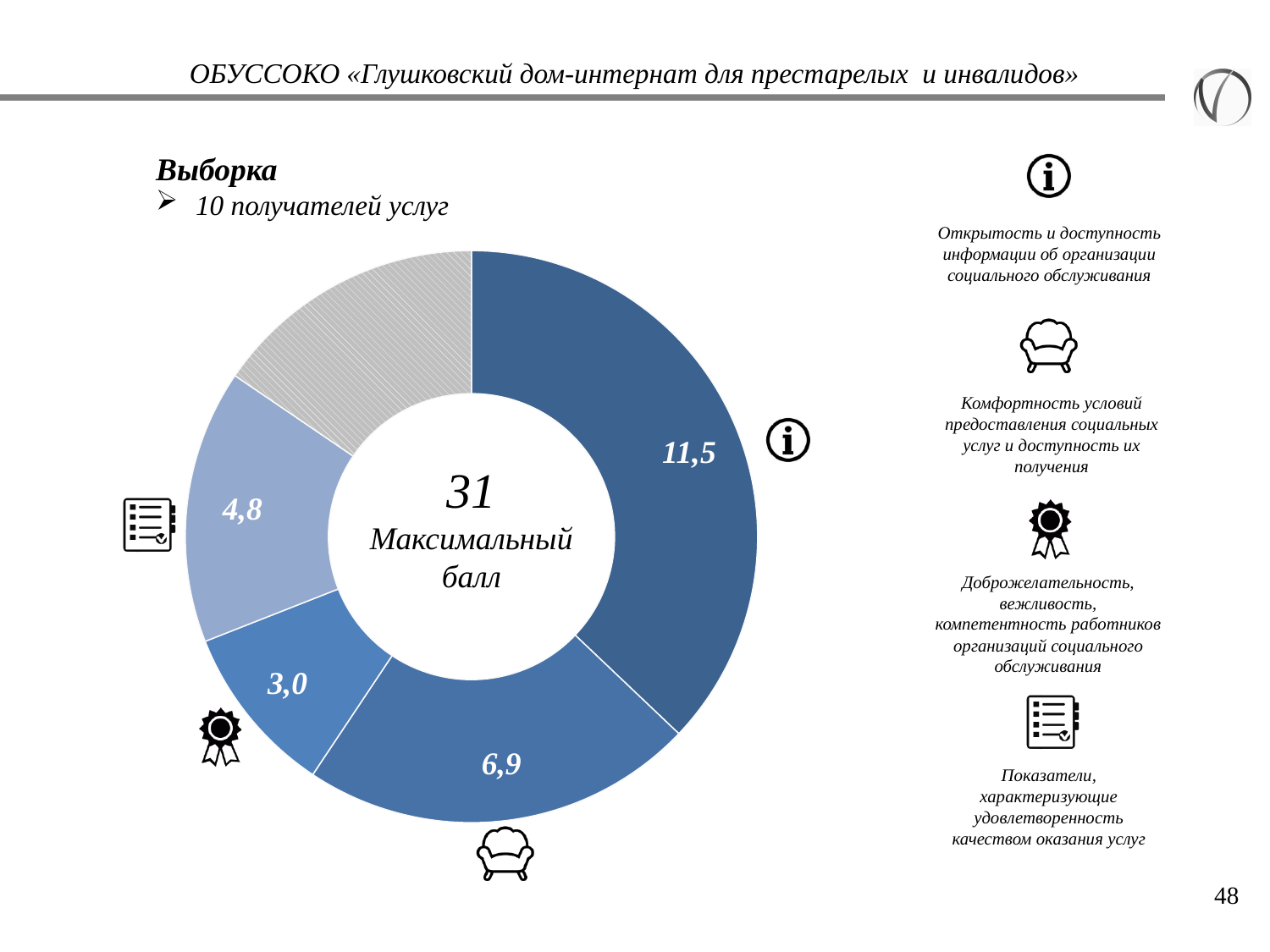
What value is shown for the slice marked with the medal icon (Доброжелательность, вежливость, компетентность работников)? 3,0 How many slices in the chart have a printed value label? 4 What number is printed in the centre of the donut chart as the maximum score (Максимальный балл)? 31 What value is shown for the slice marked with the checklist icon (Показатели, характеризующие удовлетворенность качеством оказания услуг)? 4,8 Which is larger: the value for the armchair icon slice or the checklist icon slice? Armchair icon slice (6,9) Which labeled slice has the lowest value? Доброжелательность, вежливость, компетентность работников (3,0) Which labeled slice has the highest value? Открытость и доступность информации (11,5) What is the difference between the checklist icon slice (4,8) and the medal icon slice (3,0)? 1,8 What kind of chart is shown on the slide? Donut (pie) chart What is the difference between the value for the information icon slice (11,5) and the armchair icon slice (6,9)? 4,6 What value is shown for the slice marked with the information icon (Открытость и доступность информации об организации социального обслуживания)? 11,5 What value is shown for the slice marked with the armchair icon (Комфортность условий предоставления социальных услуг)? 6,9